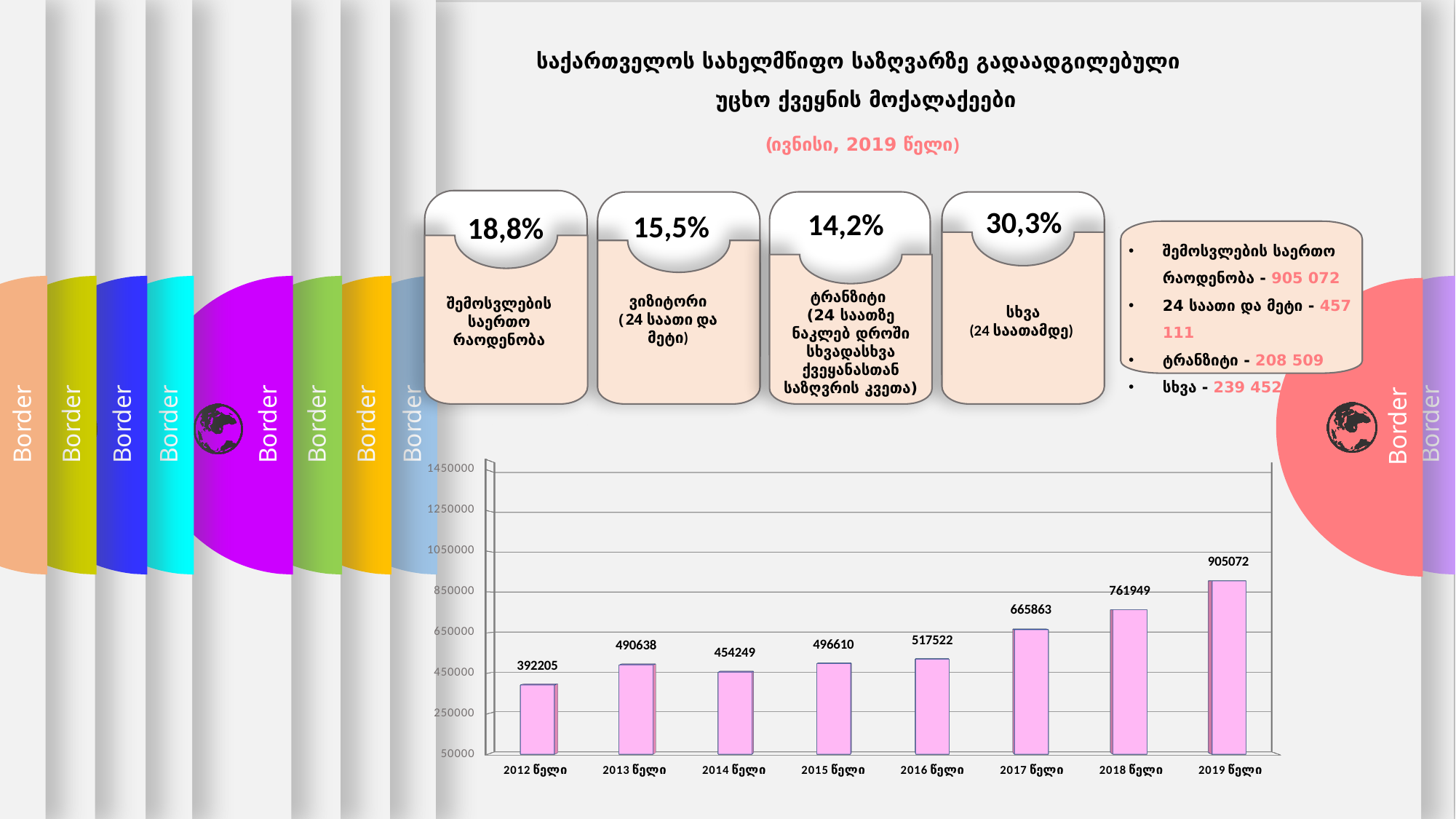
What is the value for 2012 წელი in the bar chart? 392205 Is the value for 2017 წელი in the bar chart greater or less than 650000? greater What is the difference between the values for 2019 წელი and 2018 წელი in the bar chart? 143123 Do the values in the bar chart generally rise or fall from 2012 წელი to 2019 წელი? rise What kind of chart is shown at the bottom of the slide? bar chart What is the value for 2014 წელი in the bar chart? 454249 What is the value for 2019 წელი in the bar chart? 905072 What is the difference between the values for 2013 წელი and 2012 წელი in the bar chart? 98433 How many years are shown on the x axis of the bar chart? 8 Which is larger in the bar chart, the value for 2013 წელი or 2014 წელი? 2013 წელი Which year has the highest value in the bar chart? 2019 წელი Which year has the lowest value in the bar chart? 2012 წელი